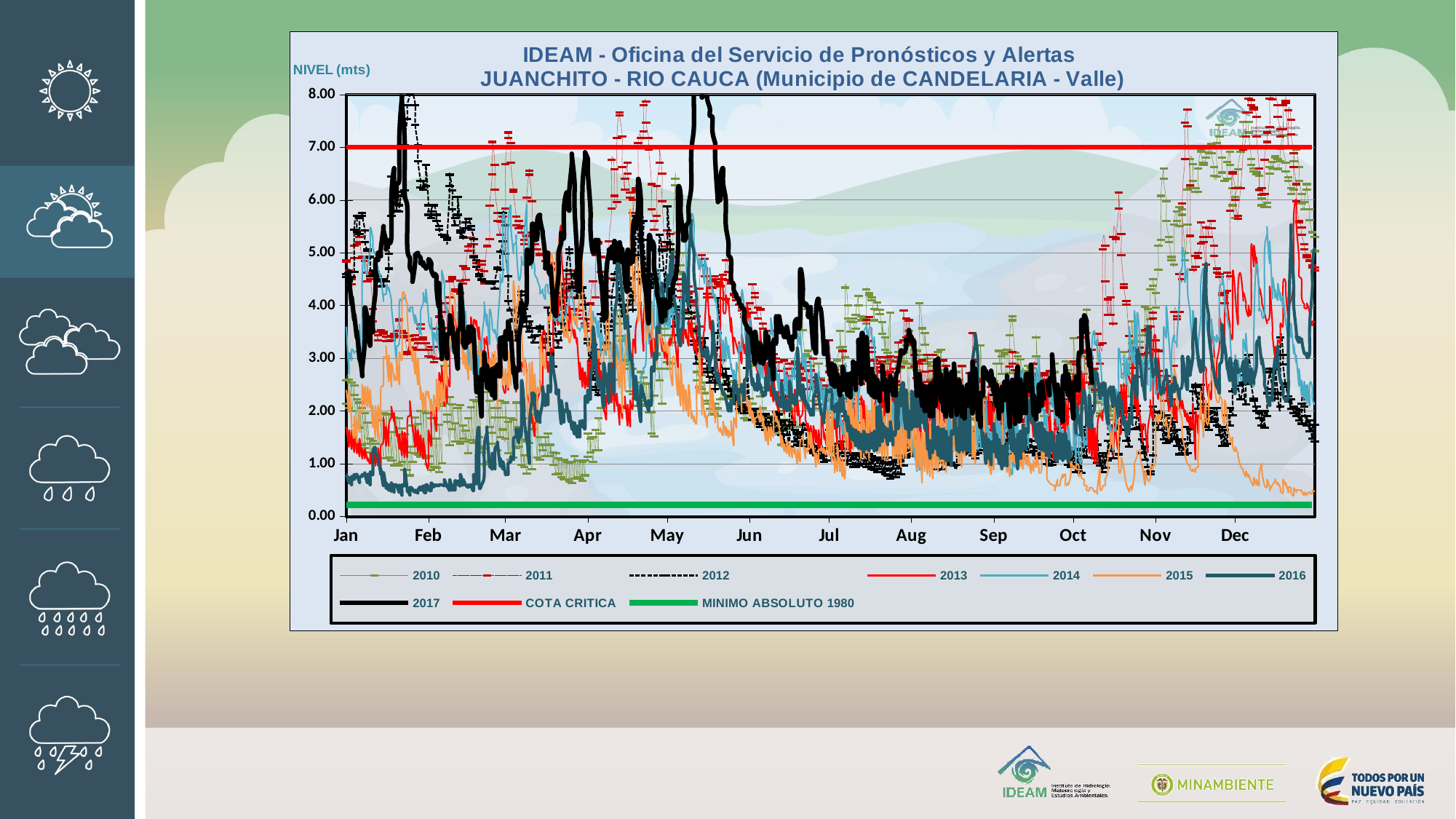
What is the level of the COTA CRITICA line on the chart? 7.00 Is the MINIMO ABSOLUTO 1980 line greater or less than 1.00? less Is the value of the 2017 series in early January greater or less than 4.00? greater What is the label of the y axis of the chart? NIVEL (mts) Is the peak of the 2017 series in mid-May greater or less than 7.00? greater What is the highest value shown on the y axis of the chart? 8.00 Which of the two reference lines is higher on the chart, COTA CRITICA or MINIMO ABSOLUTO 1980? COTA CRITICA How many months are labelled along the x axis of the chart? 12 How many entries does the chart legend list? 10 What kind of chart is shown on the slide? line chart Which station and river does the chart title name? JUANCHITO - RIO CAUCA